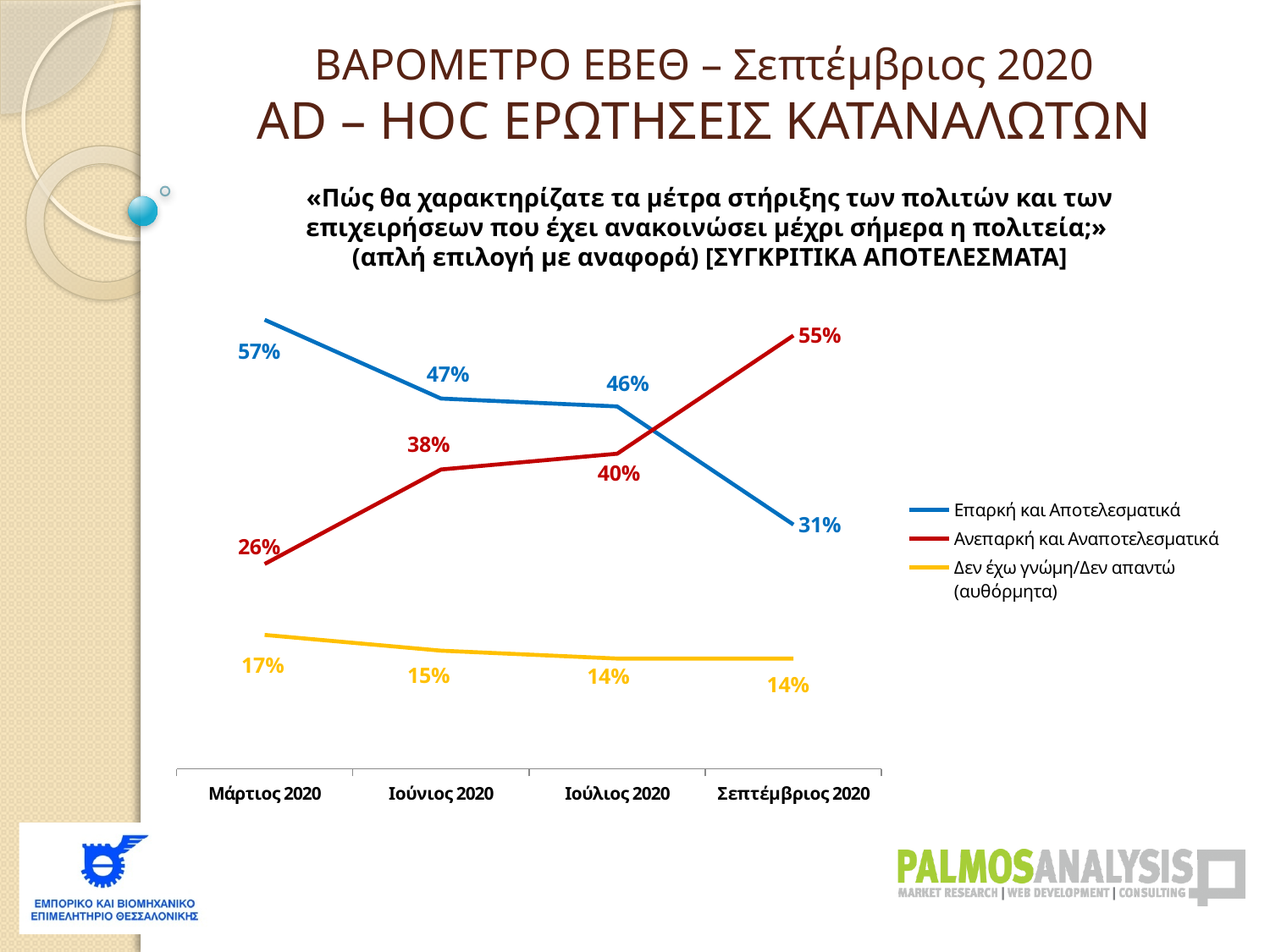
How many time points are shown on the x axis? 4 Does the value for Επαρκή και Αποτελεσματικά rise or fall from Μάρτιος 2020 to Σεπτέμβριος 2020? fall What is the value for Δεν έχω γνώμη/Δεν απαντώ (αυθόρμητα) in Ιούνιος 2020? 15% In which month is the value for Επαρκή και Αποτελεσματικά highest? Μάρτιος 2020 Which colour is used for the Ανεπαρκή και Αναποτελεσματικά line? red In which month is the value for Ανεπαρκή και Αναποτελεσματικά lowest? Μάρτιος 2020 What is the difference between Ανεπαρκή και Αναποτελεσματικά and Επαρκή και Αποτελεσματικά in Σεπτέμβριος 2020? 24% How many series does the legend list? 3 What is the value for Ανεπαρκή και Αναποτελεσματικά in Σεπτέμβριος 2020? 55% What is the value for Επαρκή και Αποτελεσματικά in Μάρτιος 2020? 57% What type of chart is shown on the slide? line chart Which series has the larger value in Ιούλιος 2020: Επαρκή και Αποτελεσματικά or Ανεπαρκή και Αναποτελεσματικά? Επαρκή και Αποτελεσματικά